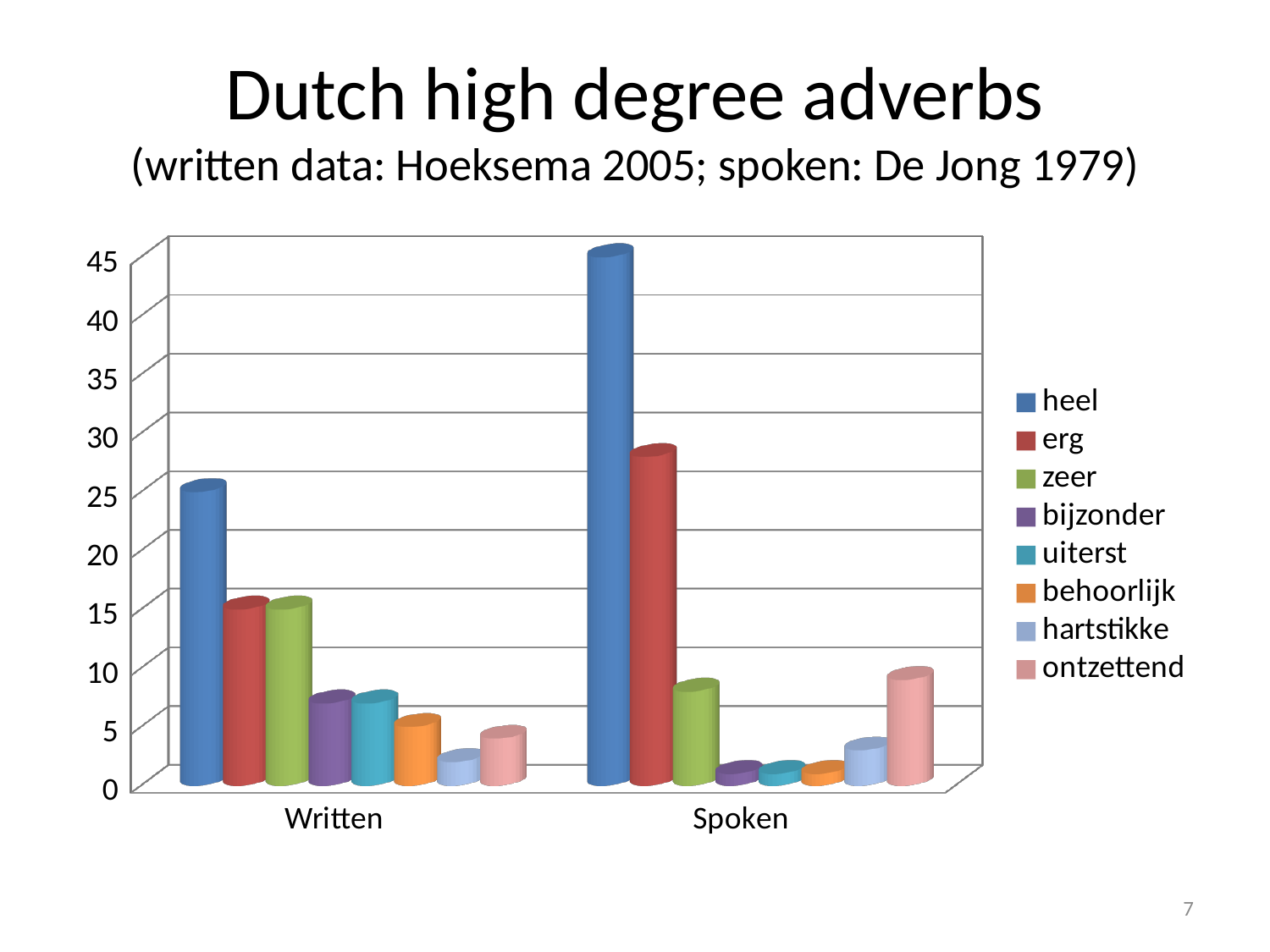
Which adverb has the lowest value in the Written category? hartstikke How many series does the legend list? 8 Is the value for heel in the Spoken category greater or less than 40? greater Is the value for erg in the Spoken category greater or less than 20? greater Which adverb has the highest value in the Written category? heel Which adverb has the highest value in the Spoken category? heel What kind of chart is shown on the slide? bar chart Is the value for ontzettend larger in the Written or the Spoken category? Spoken What is the main title of the slide containing the chart? Dutch high degree adverbs How many categories are shown on the x axis of the chart? 2 Is the value for heel larger in the Written or the Spoken category? Spoken Is the value for heel in the Written category greater or less than 20? greater